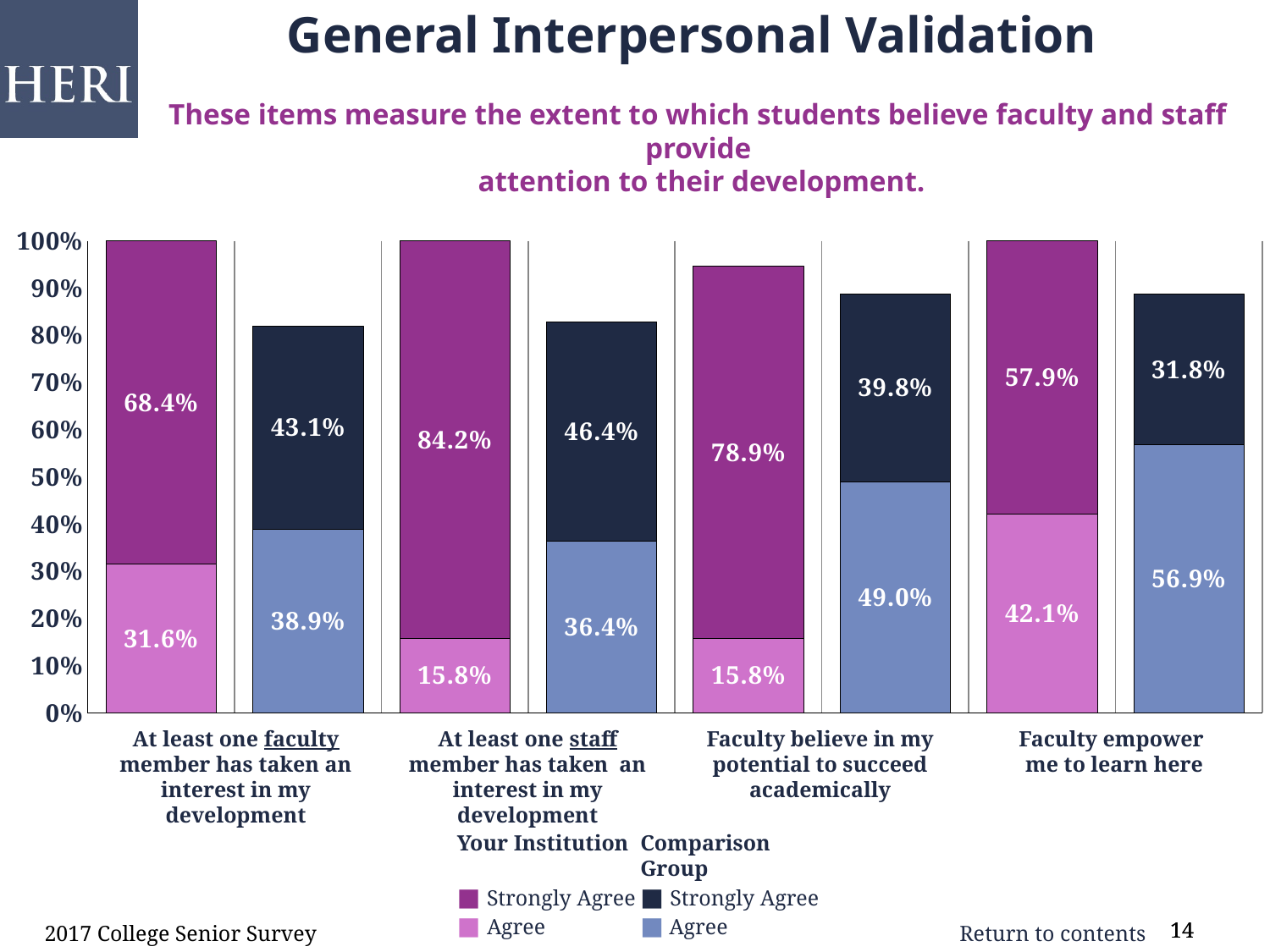
How many survey items are shown along the x axis of the chart? 4 What is the Your Institution Agree value for "Faculty empower me to learn here"? 42.1% What type of chart is shown on the slide? Stacked bar chart For "Faculty empower me to learn here", which is larger: the Comparison Group's Agree value or its Strongly Agree value? Agree (56.9%) What is the combined Strongly Agree and Agree total for the Comparison Group on "At least one faculty member has taken an interest in my development"? 82.0% Which item has the highest Your Institution Strongly Agree value? At least one staff member has taken an interest in my development What is the difference between the Your Institution and Comparison Group Strongly Agree values for "At least one staff member has taken an interest in my development"? 37.8 percentage points How many series does the legend list? 4 What is the combined Strongly Agree and Agree total for Your Institution on "Faculty believe in my potential to succeed academically"? 94.7% What is the Comparison Group's Agree value for "Faculty believe in my potential to succeed academically"? 49.0% Which item has the lowest Comparison Group Strongly Agree value? Faculty empower me to learn here What percentage of students at Your Institution strongly agree that at least one faculty member has taken an interest in their development? 68.4%